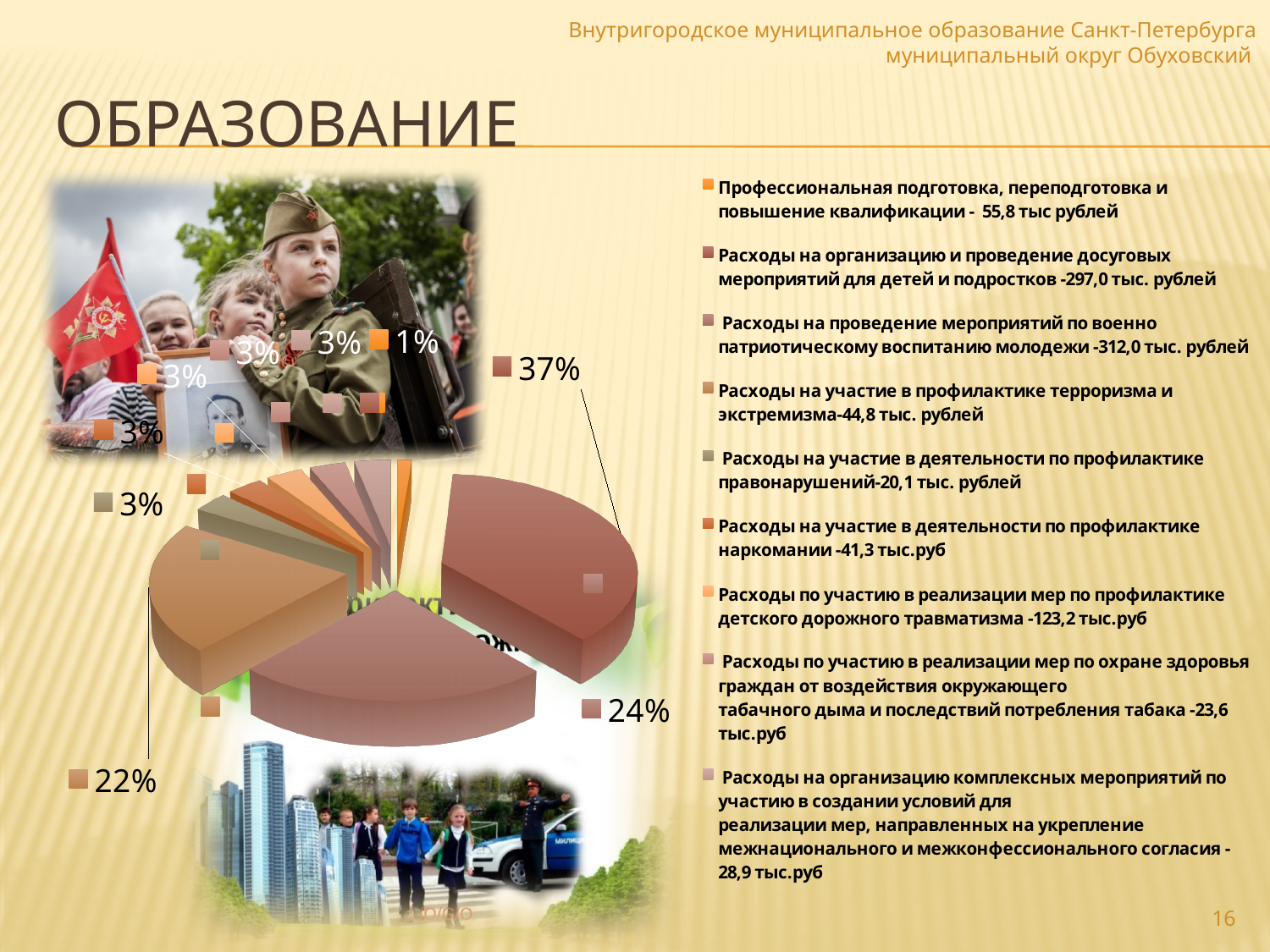
What is the difference in percentage points between the slices labelled 24% and 22%? 2 What kind of chart is shown on the slide? pie chart What is the percentage of the smallest slice in the pie chart? 1% What is the percentage of the largest slice in the pie chart? 37% What is the combined share of the three largest slices (37%, 24% and 22%)? 83% Does the largest slice of the pie chart account for more or less than half of the pie? less How many slices in the pie chart are labelled 3%? 5 How many slices does the pie chart have? 9 Is the pie chart drawn in 3D? yes Which is larger, the slice labelled 24% or the slice labelled 22%? 24% What is the difference in percentage points between the largest slice (37%) and the second largest slice (24%)? 13